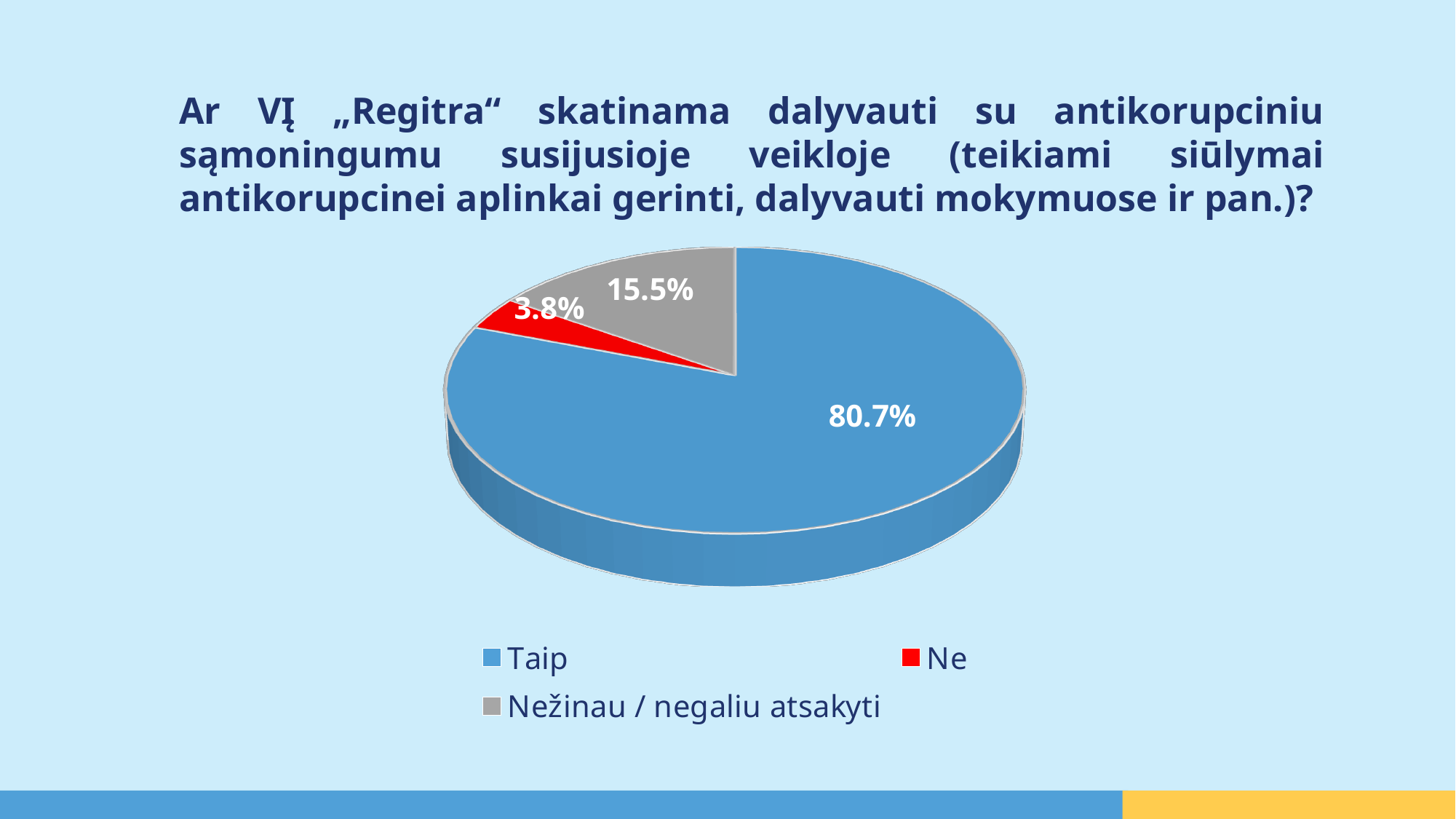
Which is larger, the share for "Ne" or the share for "Nežinau / negaliu atsakyti"? Nežinau / negaliu atsakyti Which answer category has the smallest share of the pie? Ne What colour is the slice for "Nežinau / negaliu atsakyti"? Grey What is the difference in percentage points between "Nežinau / negaliu atsakyti" and "Ne"? 11.7 What is the difference in percentage points between "Taip" and "Nežinau / negaliu atsakyti"? 65.2 What colour is the slice for "Ne"? Red How many slices does the pie chart have? 3 Which answer category has the largest share of the pie? Taip What percentage of respondents answered "Taip"? 80.7% What kind of chart is shown on the slide? Pie chart What percentage of respondents answered "Ne"? 3.8% What percentage of respondents answered "Nežinau / negaliu atsakyti"? 15.5%